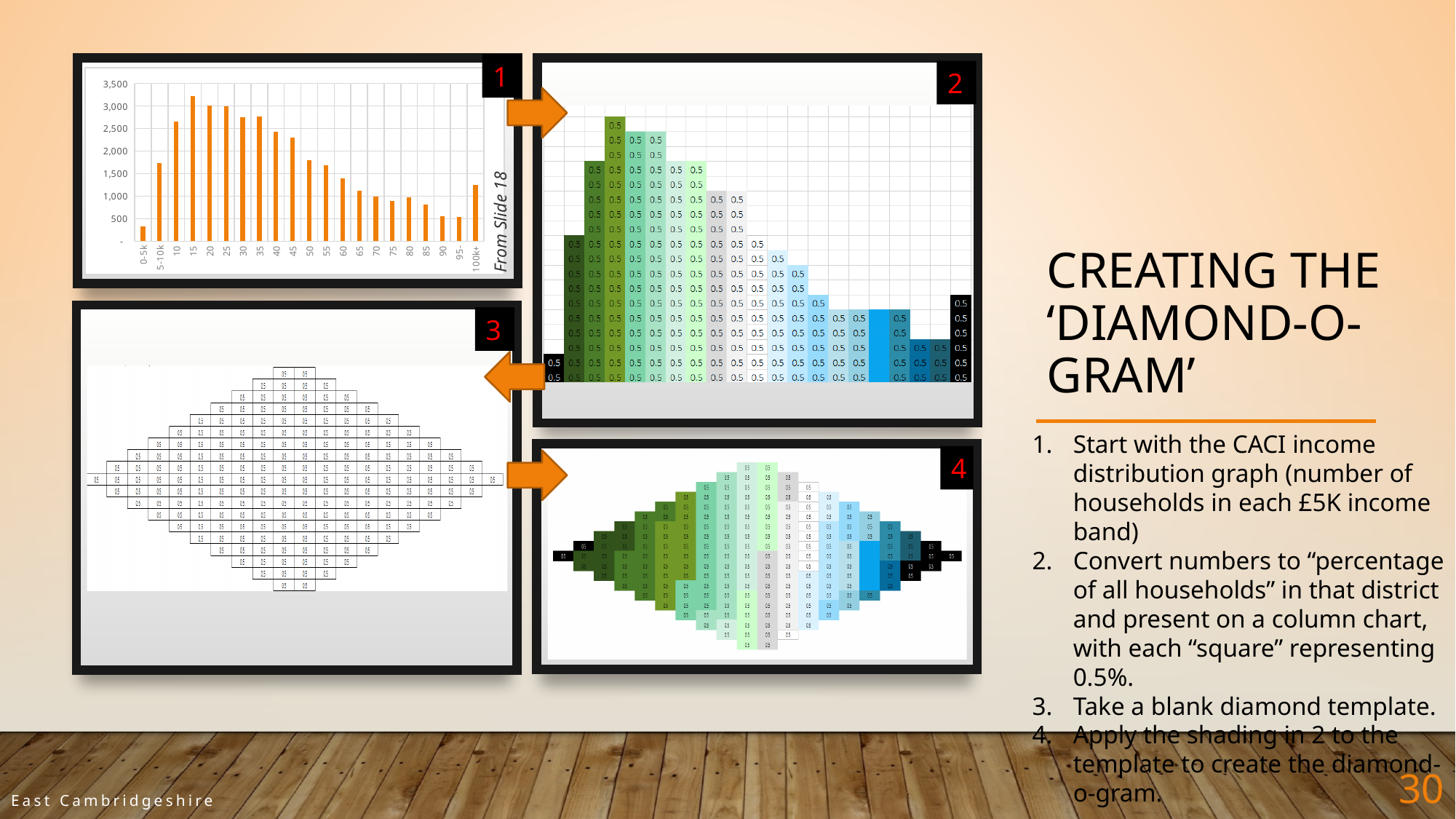
In chart 1 (top-left), what colour are the bars? orange In chart 1 (top-left, the orange bar chart), what kind of chart is shown? bar chart In chart 1 (top-left), is the value for 90 greater or less than 1,000? less In chart 1 (top-left), which income band has the lowest bar? 0-5k In chart 1 (top-left), which is larger, the value for 10 or the value for 100k+? 10 In chart 1 (top-left), how many income bands are shown on the x axis? 21 In chart 1 (top-left), is the value for 15 greater or less than 3,000? greater In chart 1 (top-left), which is larger, the value for 0-5k or the value for 5-10k? 5-10k In chart 1 (top-left), do the values rise or fall along the x axis from 15 to 60? fall In chart 1 (top-left), which income band has the highest bar? 15 In chart 1 (top-left), is the value for 0-5k greater or less than 500? less